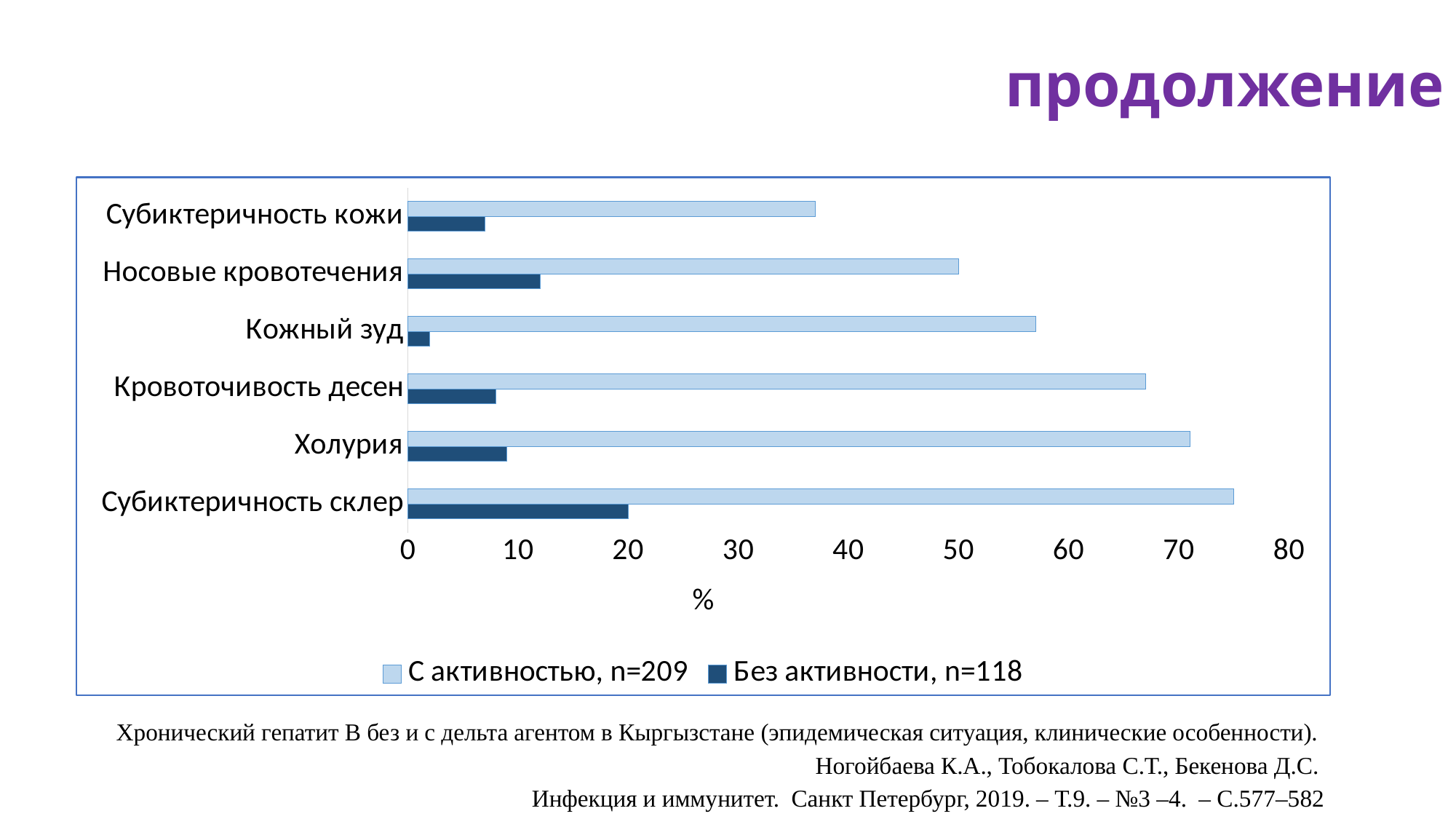
Which category has the lowest value for the series 'Без активности, n=118'? Кожный зуд What kind of chart is shown on the slide? bar chart Which category has the highest value for the series 'С активностью, n=209'? Субиктеричность склер Is the value for 'Кровоточивость десен' in the series 'С активностью, n=209' greater or less than 60? greater Is the value for 'Кожный зуд' in the series 'С активностью, n=209' greater or less than 50? greater Is the value for 'Субиктеричность кожи' in the series 'С активностью, n=209' greater or less than 40? less Which category has the highest value for the series 'Без активности, n=118'? Субиктеричность склер What is the label of the horizontal axis? % For 'Носовые кровотечения', which series has the larger value: 'С активностью, n=209' or 'Без активности, n=118'? С активностью, n=209 How many categories (symptoms) are shown on the chart? 6 Which category has the lowest value for the series 'С активностью, n=209'? Субиктеричность кожи How many series does the legend list? 2